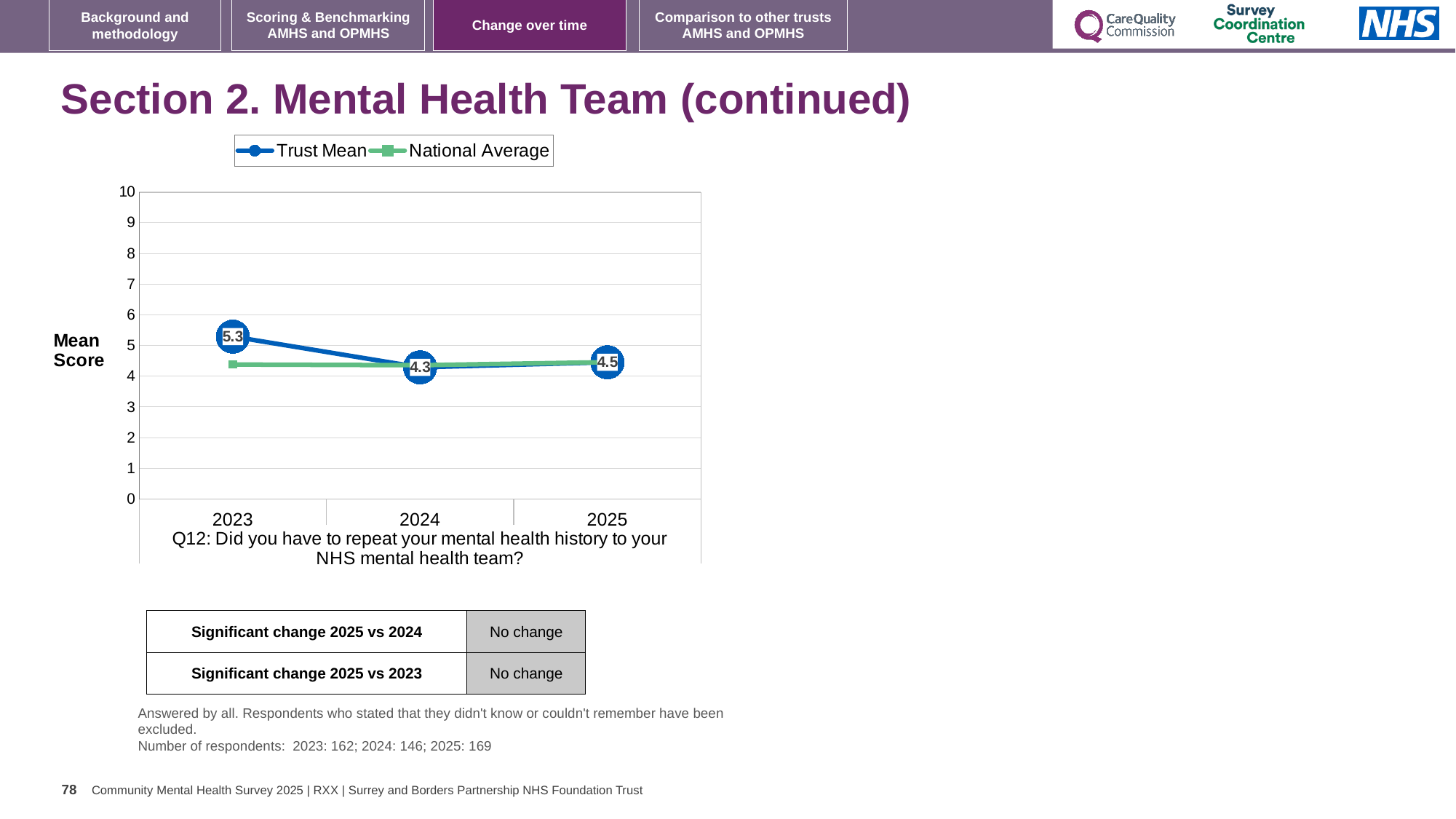
What is the Trust Mean score for 2024? 4.3 What is the Trust Mean score for 2023? 5.3 How many series does the legend list? 2 Does the Trust Mean rise or fall from 2023 to 2024? Fall What kind of chart is shown on the slide? Line chart How many years are plotted on the x axis? 3 Which is larger, the Trust Mean in 2023 or in 2025? 2023 Is the National Average value for 2023 greater or less than 5? less What is the difference between the Trust Mean in 2023 and in 2024? 1.0 In which year is the Trust Mean lowest? 2024 In which year is the Trust Mean highest? 2023 What is the Trust Mean score for 2025? 4.5